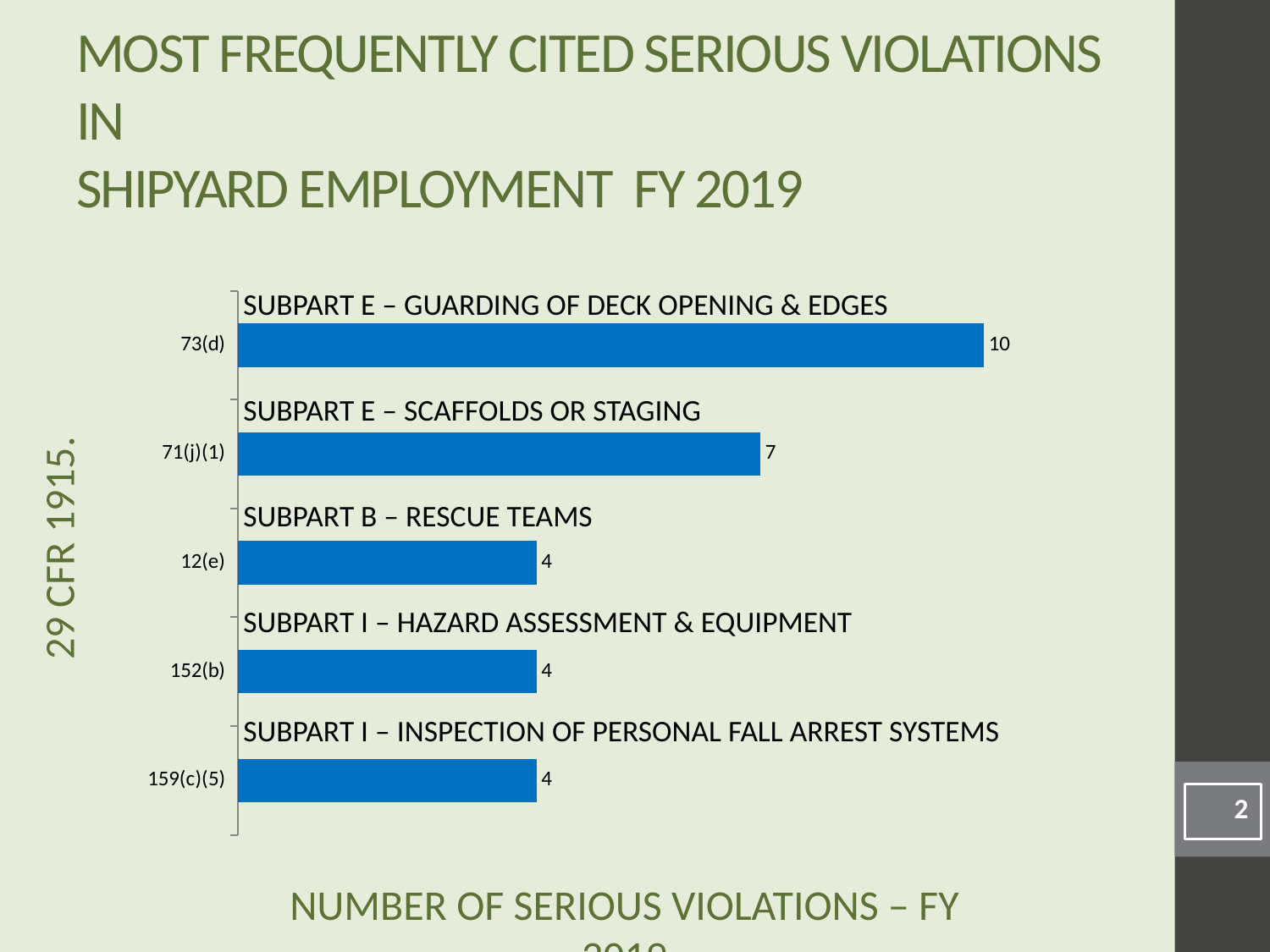
How many serious violations are shown for 12(e)? 4 Which category has the highest number of serious violations? 73(d) How many categories have a value of 4? 3 What is the value for 71(j)(1)? 7 How many categories are plotted in the chart? 5 What kind of chart is shown on the slide? Bar chart What is the difference between the values for 73(d) and 71(j)(1)? 3 How many serious violations are shown for 73(d)? 10 What is the y-axis title of the chart? 29 CFR 1915. Which is larger, the value for 73(d) or the value for 159(c)(5)? 73(d) What is the difference between the values for 71(j)(1) and 152(b)? 3